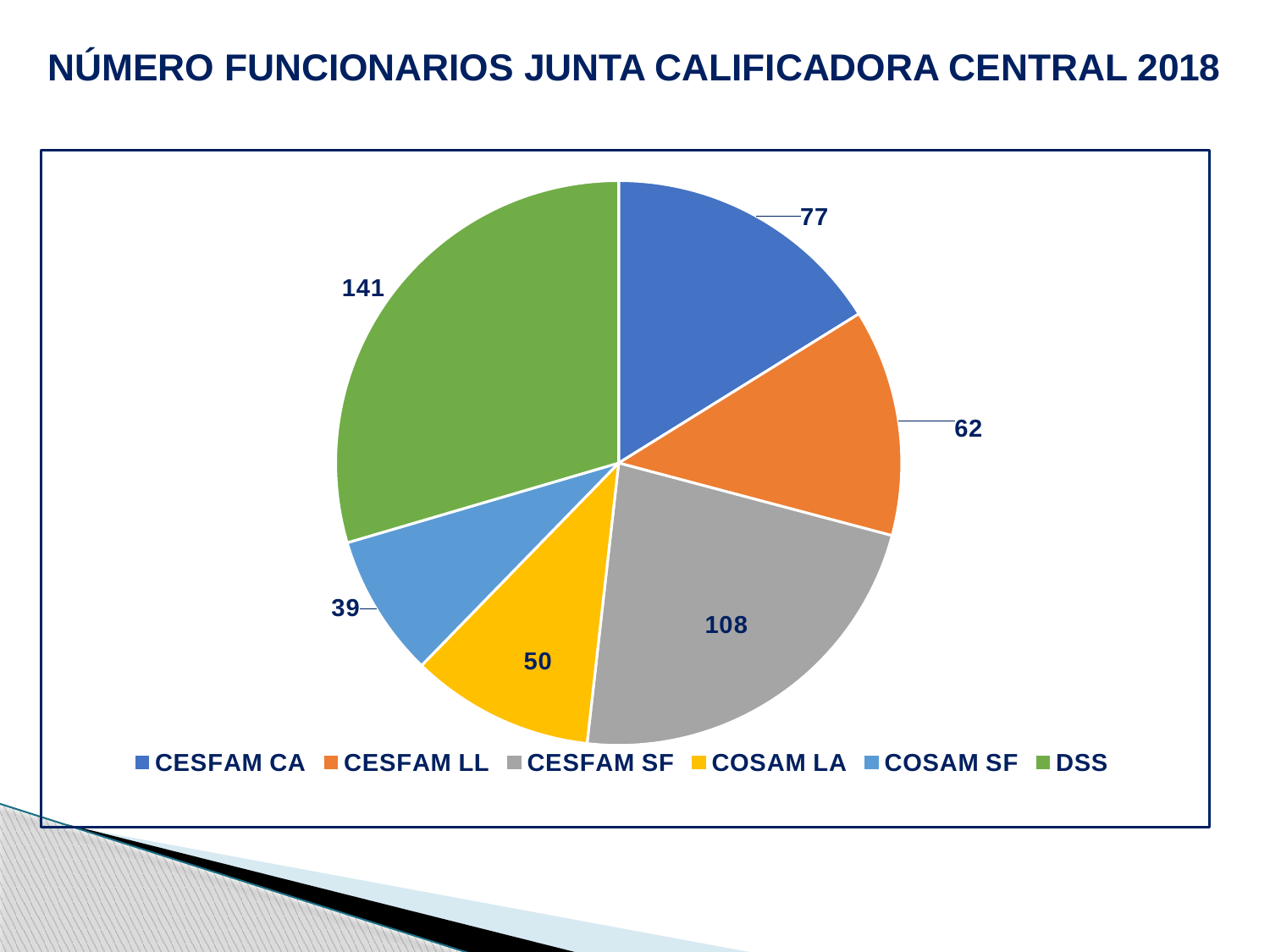
What is the value for CESFAM LL? 62 What is the value for DSS? 141 What is the value for CESFAM SF? 108 Which category has the largest slice? DSS How many categories does the pie chart have? 6 What is the title of the chart? NÚMERO FUNCIONARIOS JUNTA CALIFICADORA CENTRAL 2018 What is the total of all slices in the pie chart? 477 What is the difference between the values for DSS and CESFAM SF? 33 Which category has the smallest slice? COSAM SF What is the value for COSAM SF? 39 Which is larger, CESFAM CA or CESFAM LL? CESFAM CA What type of chart is shown on the slide? Pie chart